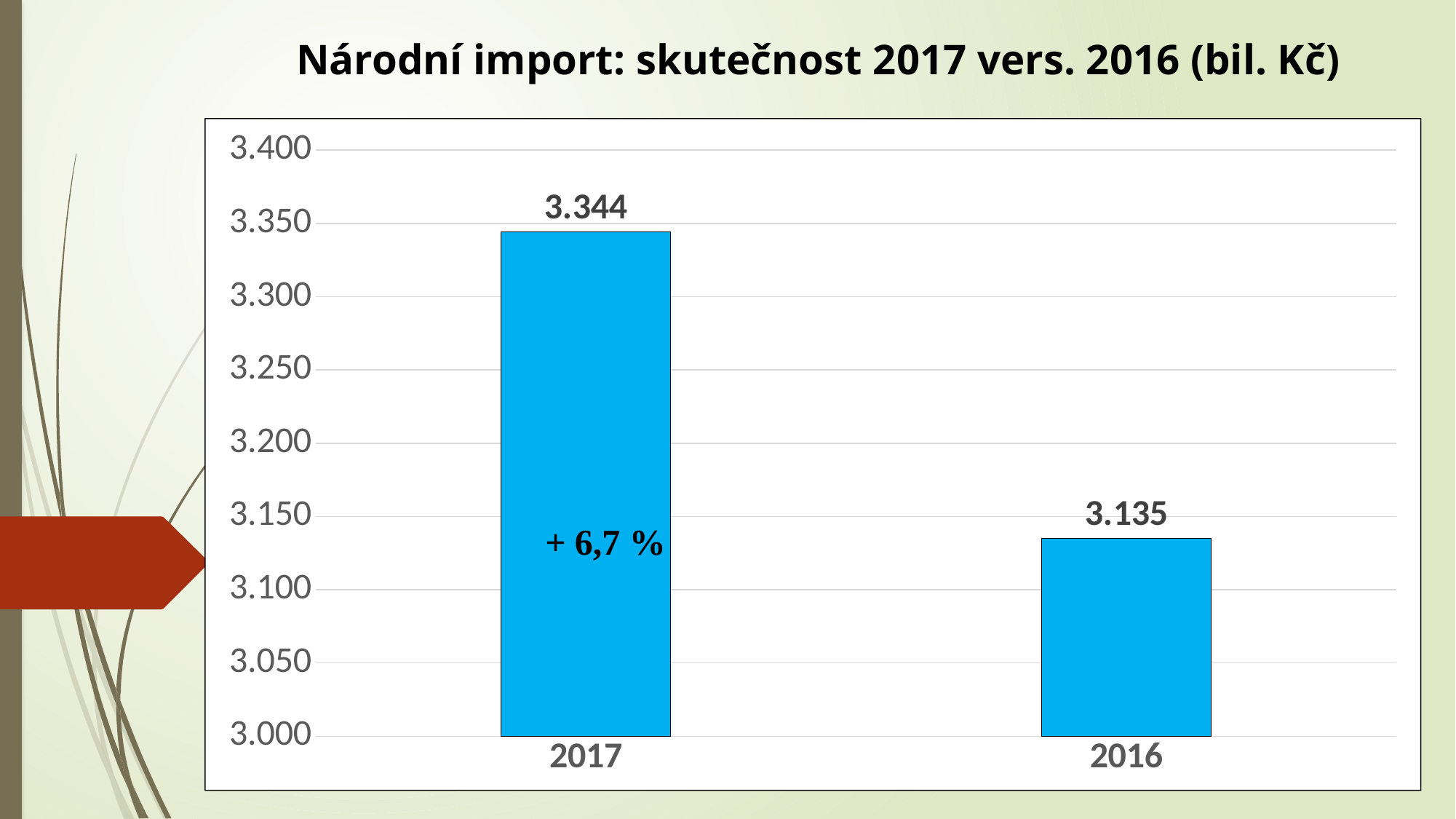
What is the difference between the 2017 and 2016 values? 0.209 Do the values rise or fall from left to right along the x axis? fall Which year has the higher value? 2017 What percentage change is printed on the 2017 bar? + 6,7 % Is the value for 2016 greater or less than 3.150? less Which year has the lower value? 2016 Is the value for 2017 larger or smaller than the value for 2016? larger What is the value for 2016? 3.135 Is the value for 2017 greater or less than 3.300? greater What kind of chart is shown on the slide? bar chart What is the value for 2017? 3.344 How many bars are shown in the chart? 2